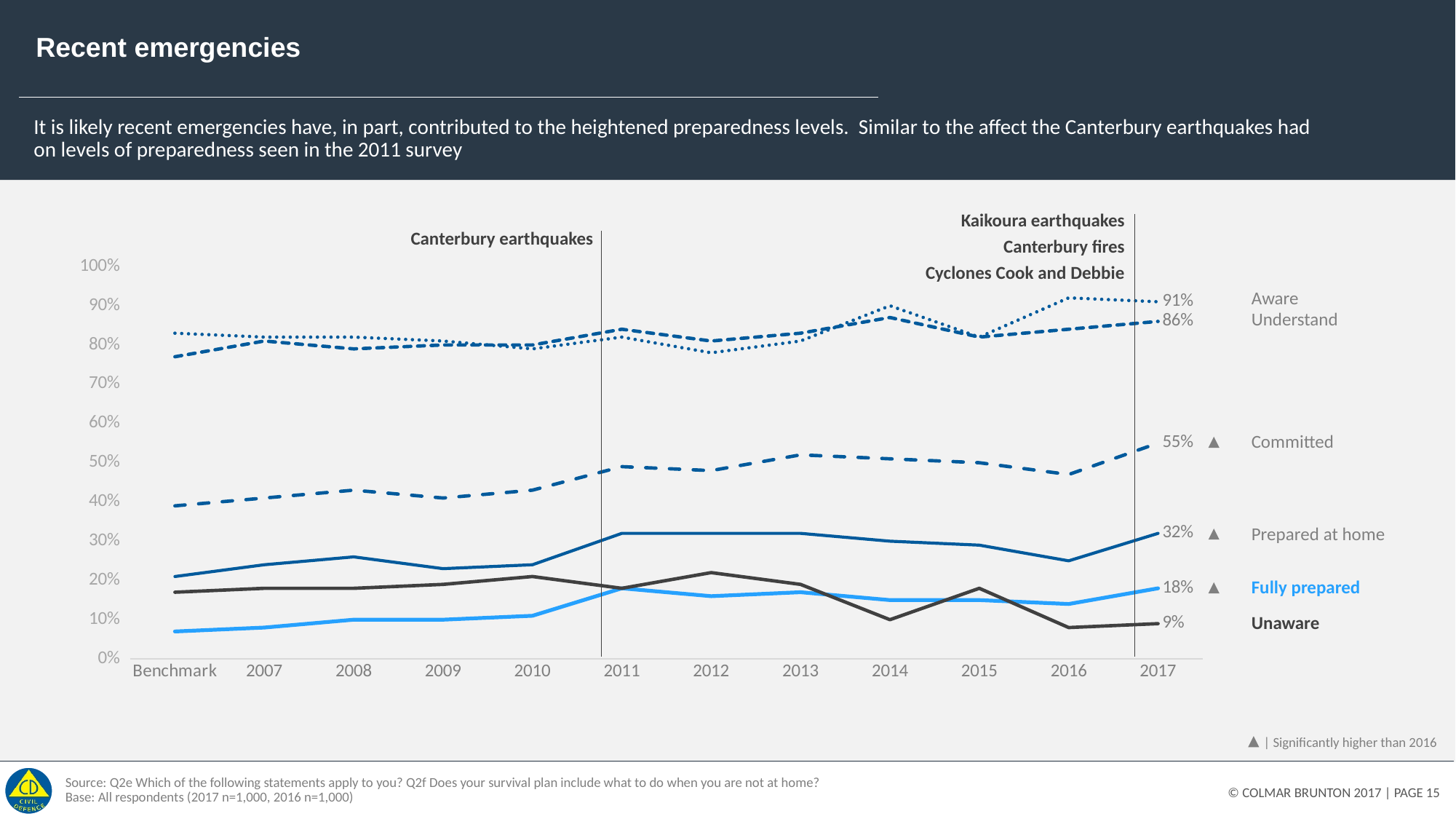
Is the value for Committed at the Benchmark point greater or less than 50%? less Which series has the highest value in 2017? Aware How many series are plotted on the chart? 6 Which series has the lowest value in 2017? Unaware Which is larger in 2017, Prepared at home or Fully prepared? Prepared at home What is the value for Fully prepared in 2017? 18% What is the difference between the 2017 values for Aware and Understand? 5% What is the value for Unaware in 2017? 9% What is the value for Committed in 2017? 55% What is the value for Aware in 2017? 91% How many points are shown along the x axis? 12 What kind of chart is shown on the slide? line chart